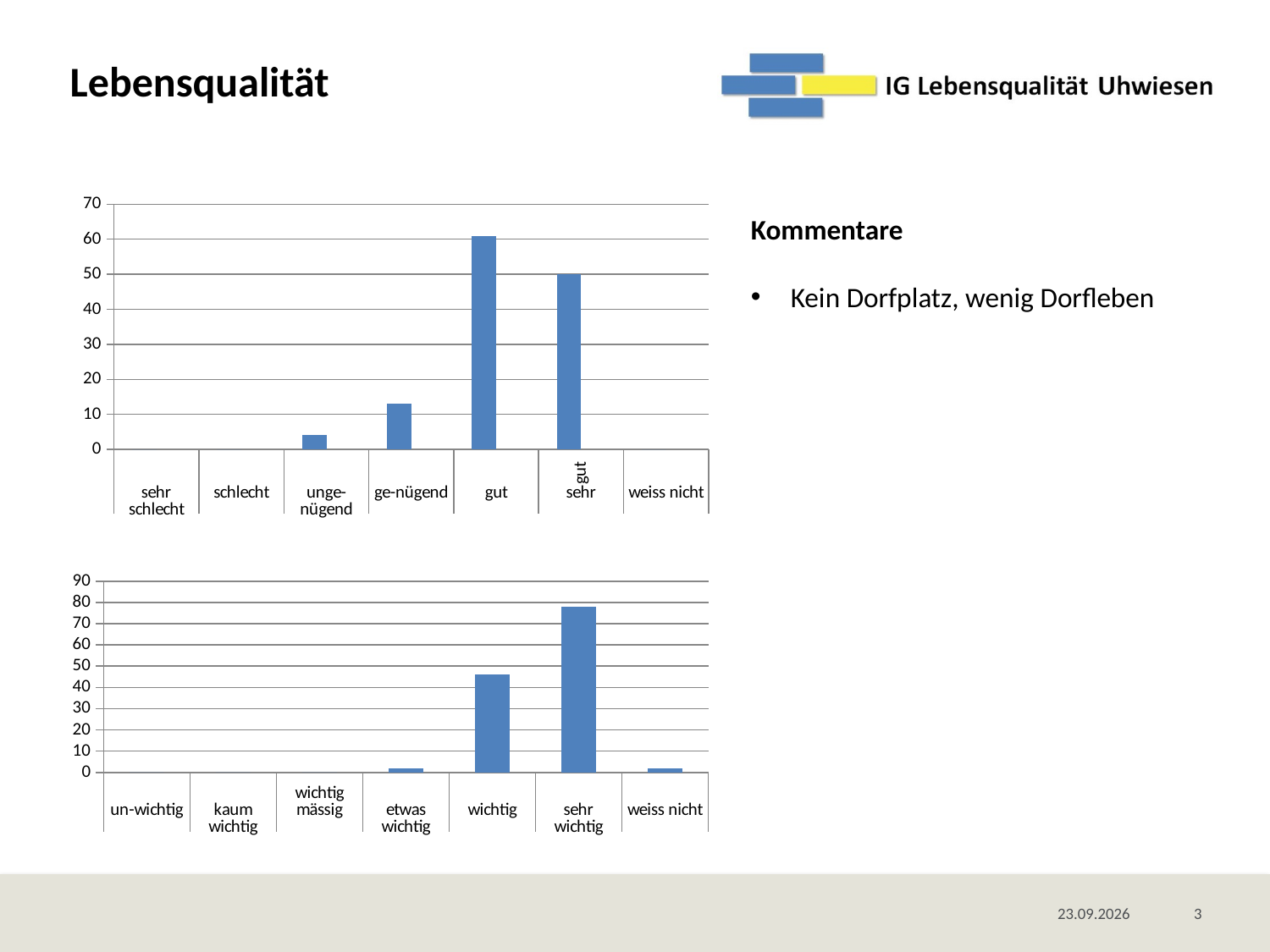
In the bottom chart, is the value for wichtig greater or less than 40? greater What is the highest value shown on the y axis of the bottom chart? 90 In the top chart, which category has the highest bar? gut In the top chart, is the value for gut greater or less than 50? greater In the bottom chart, which category has the highest bar? sehr wichtig In the top chart, is the value for ge-nügend greater or less than 20? less In the bottom chart, which is larger, the value for wichtig or the value for sehr wichtig? sehr wichtig In the top chart, which is larger, the value for gut or the value for sehr gut? gut How many categories are shown on the x axis of the top chart? 7 How many categories are shown on the x axis of the bottom chart? 7 What kind of chart is the top chart on the slide? bar chart